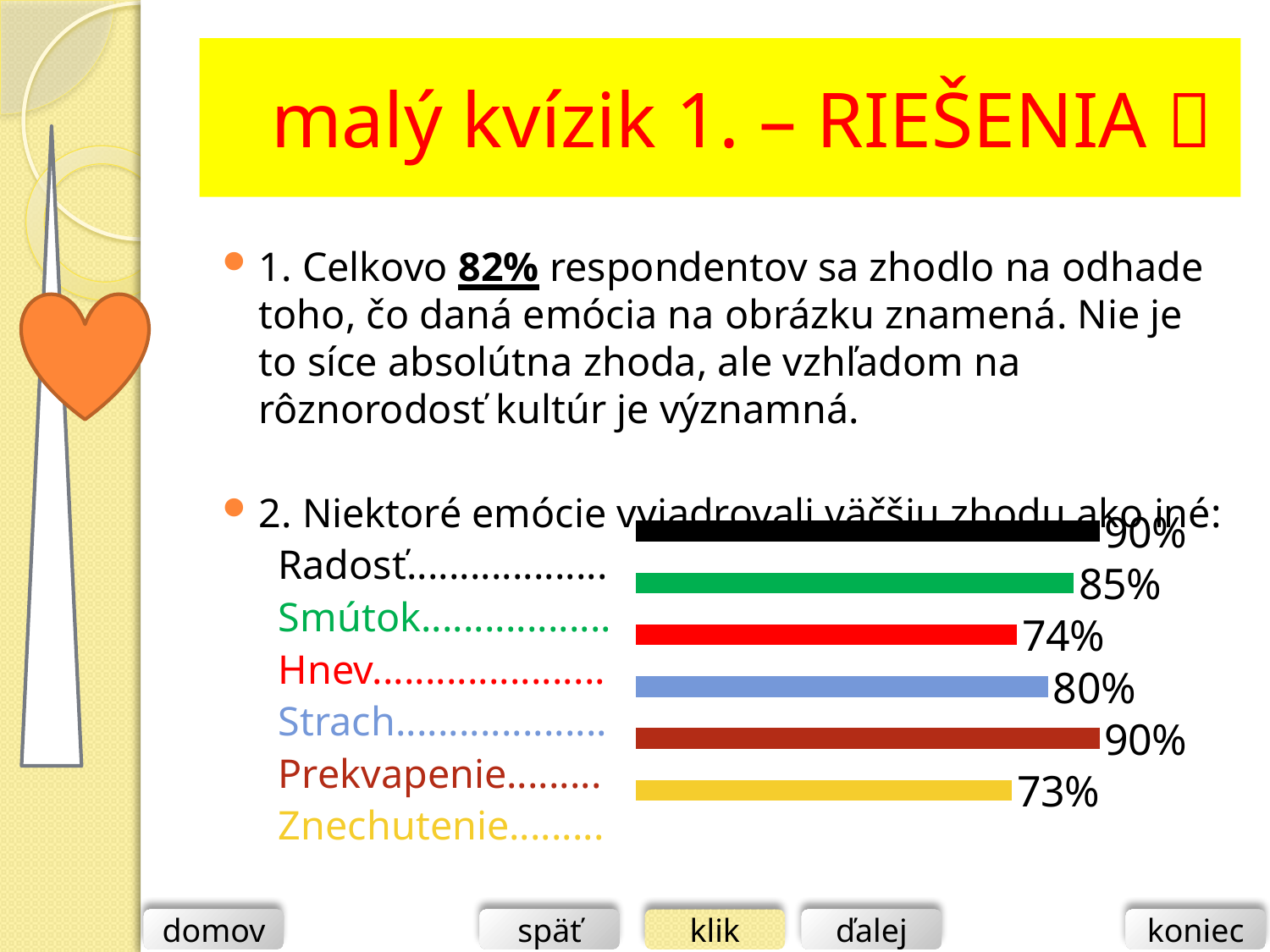
How many bars are in the bar chart? 6 What is the difference between the values for Smútok and Hnev? 11% Which has a larger value, Strach or Hnev? Strach What value is shown for Hnev in the bar chart? 74% Which two emotions share the highest value in the bar chart? Radosť and Prekvapenie What is the difference between the values for Radosť and Znechutenie? 17% What type of chart is shown on the slide? Bar chart What value is shown for Smútok in the bar chart? 85% Which emotion has the lowest value in the bar chart? Znechutenie What value is shown for Strach in the bar chart? 80% What value is shown for Znechutenie in the bar chart? 73% What value is shown for Prekvapenie in the bar chart? 90%